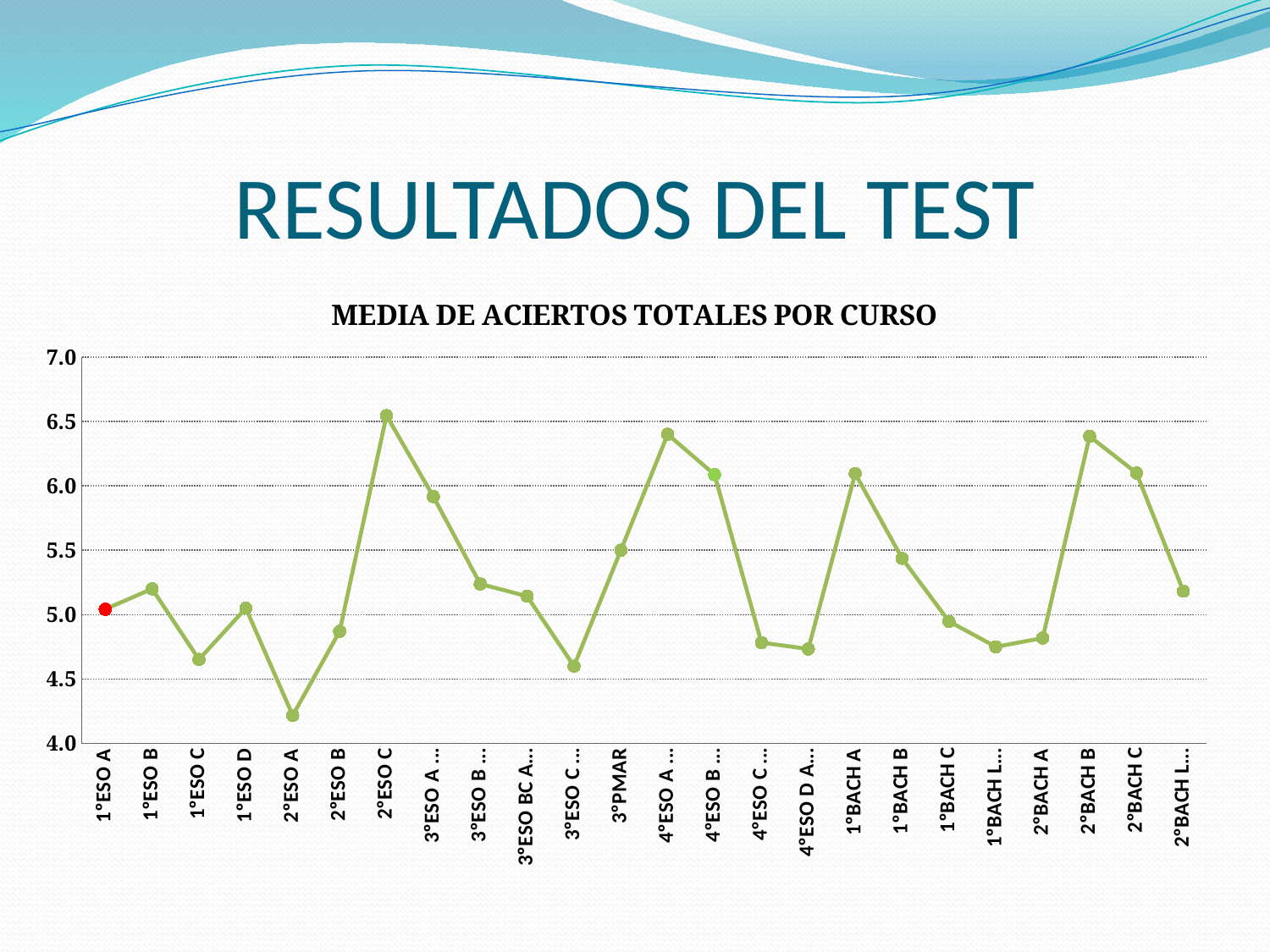
Is the value for 2°ESO C greater or less than 6.0? greater Is the value for 2°ESO A greater or less than 4.5? less What is the title of the chart? MEDIA DE ACIERTOS TOTALES POR CURSO Which course has the lowest value in the chart? 2°ESO A Is the value for 1°BACH A greater or less than 5.5? greater Which has a higher value, 1°ESO B or 1°ESO C? 1°ESO B Which has a higher value, 2°BACH B or 2°BACH A? 2°BACH B What kind of chart is shown on the slide? line chart Do the values rise or fall from 2°ESO A to 2°ESO C? rise What colour is the marker for the first point, 1°ESO A? red Which course has the highest value in the chart? 2°ESO C